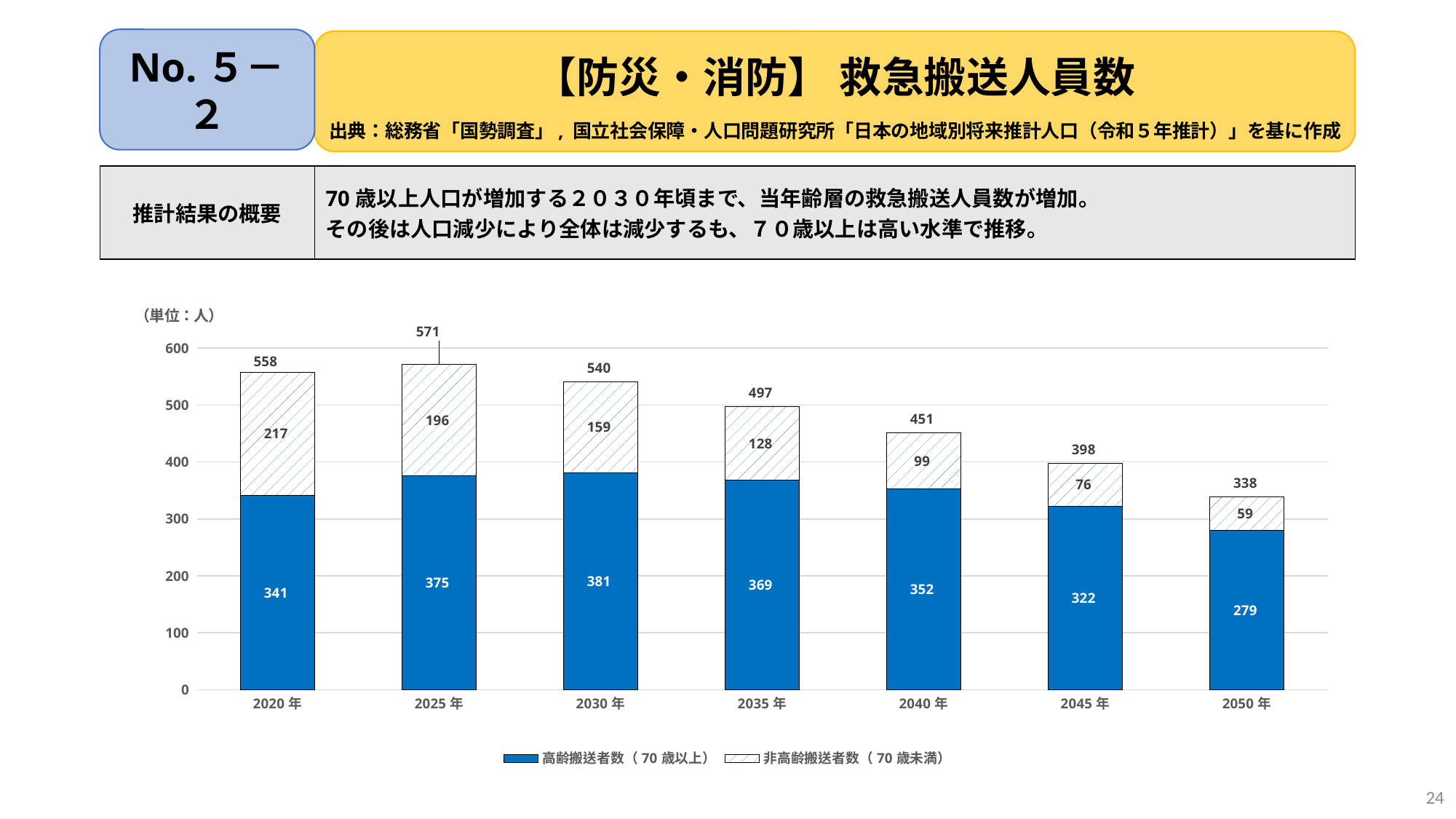
What is the value for 高齢搬送者数（70歳以上） in 2030年? 381 What is the value for 非高齢搬送者数（70歳未満） in 2020年? 217 How many years are shown on the x axis? 7 Do the values for 非高齢搬送者数（70歳未満） rise or fall from 2020年 to 2050年? Fall Which year has the highest total 救急搬送人員数? 2025年 What kind of chart is shown on the slide? Stacked bar chart What unit is indicated above the chart? 人 Which is larger: 非高齢搬送者数（70歳未満） in 2035年 or in 2040年? 2035年 How many series does the legend list? 2 What is the difference between the 高齢搬送者数（70歳以上） values for 2030年 and 2050年? 102 What is the total of the stacked bar for 2025年? 571 Which year has the lowest value for 非高齢搬送者数（70歳未満）? 2050年